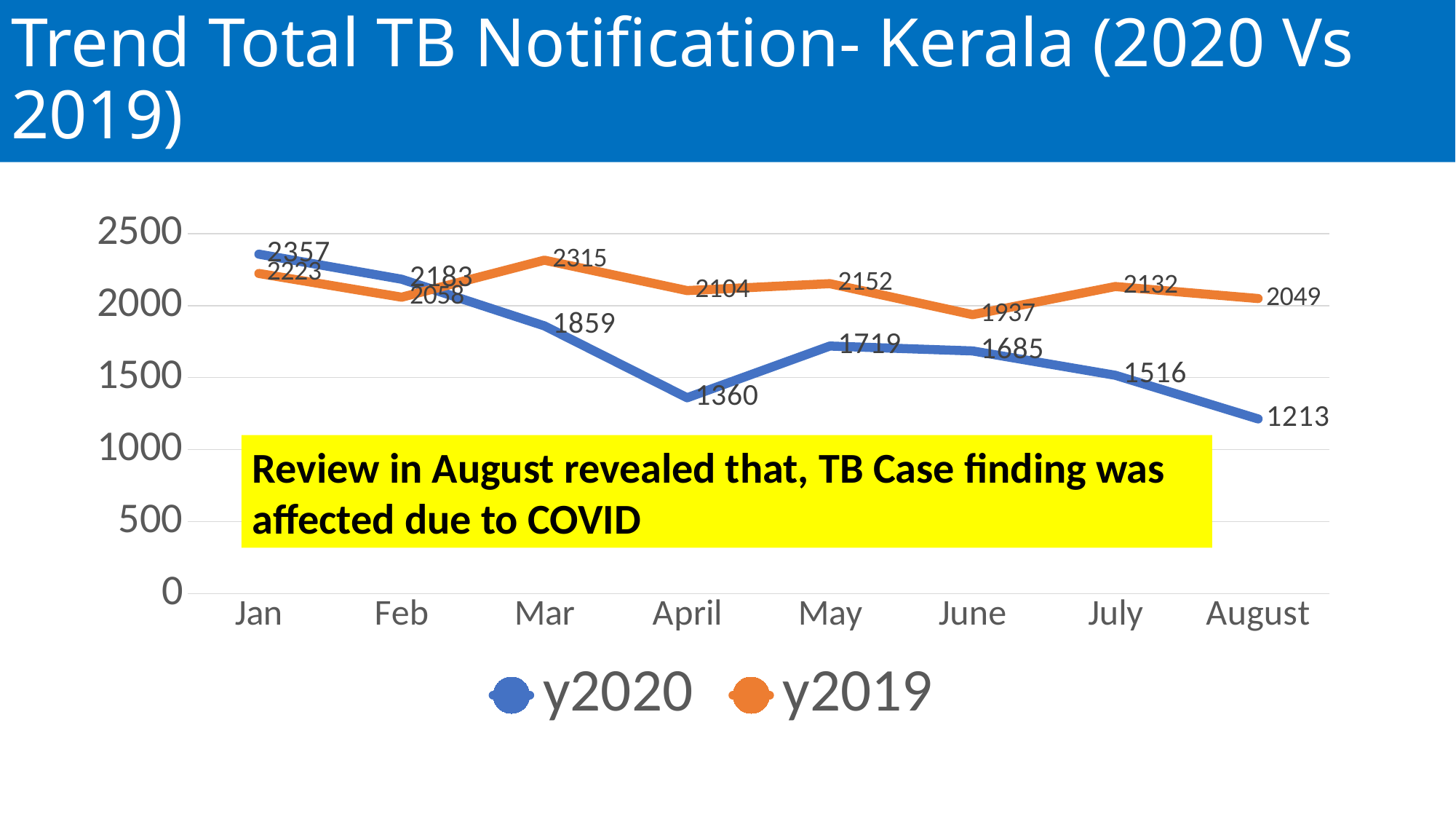
What type of chart is shown on the slide? line chart In which month is the y2019 value highest? Mar What is the y2020 value for August? 1213 What colour is the y2019 line? orange What is the y2019 value for March? 2315 Which series has the larger value in Jan, y2020 or y2019? y2020 How many months are plotted along the x axis? 8 Does the y2020 series generally rise or fall from Jan to August? fall How many series does the legend list? 2 What is the difference between the y2019 and y2020 values for August? 836 In which month is the y2020 value lowest? August What is the y2020 value for April? 1360